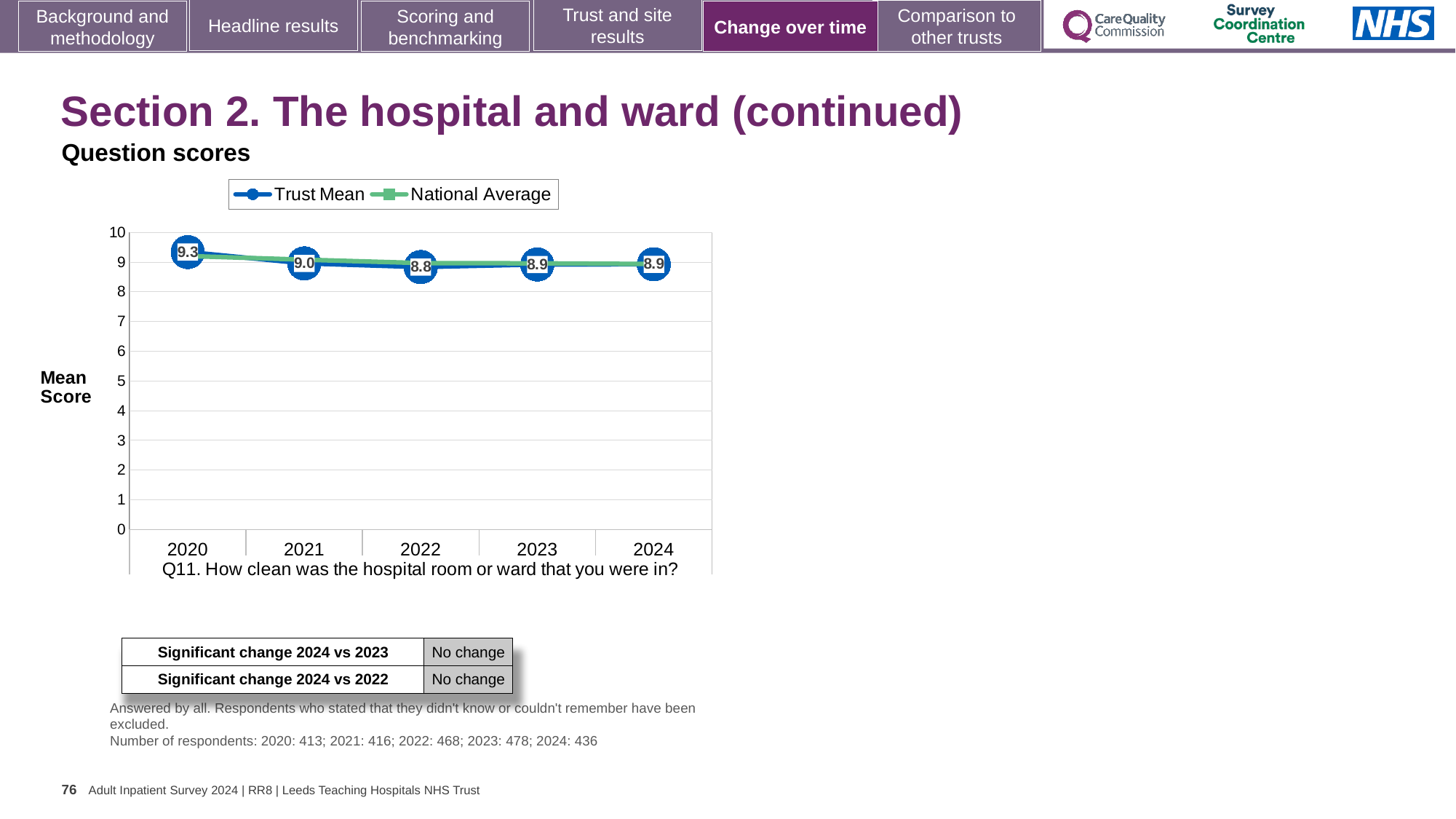
Which is larger, the Trust Mean in 2020 or in 2021? 2020 Is the National Average for 2020 greater or less than 8? greater What is the Trust Mean for 2021? 9.0 How many series does the legend list? 2 What is the difference between the Trust Mean in 2020 and in 2022? 0.5 What is the Trust Mean for 2024? 8.9 In which year is the Trust Mean highest? 2020 What is the Trust Mean for 2020? 9.3 How many years are shown on the x axis? 5 In which year is the Trust Mean lowest? 2022 What type of chart is shown? line chart What is the Trust Mean for 2022? 8.8